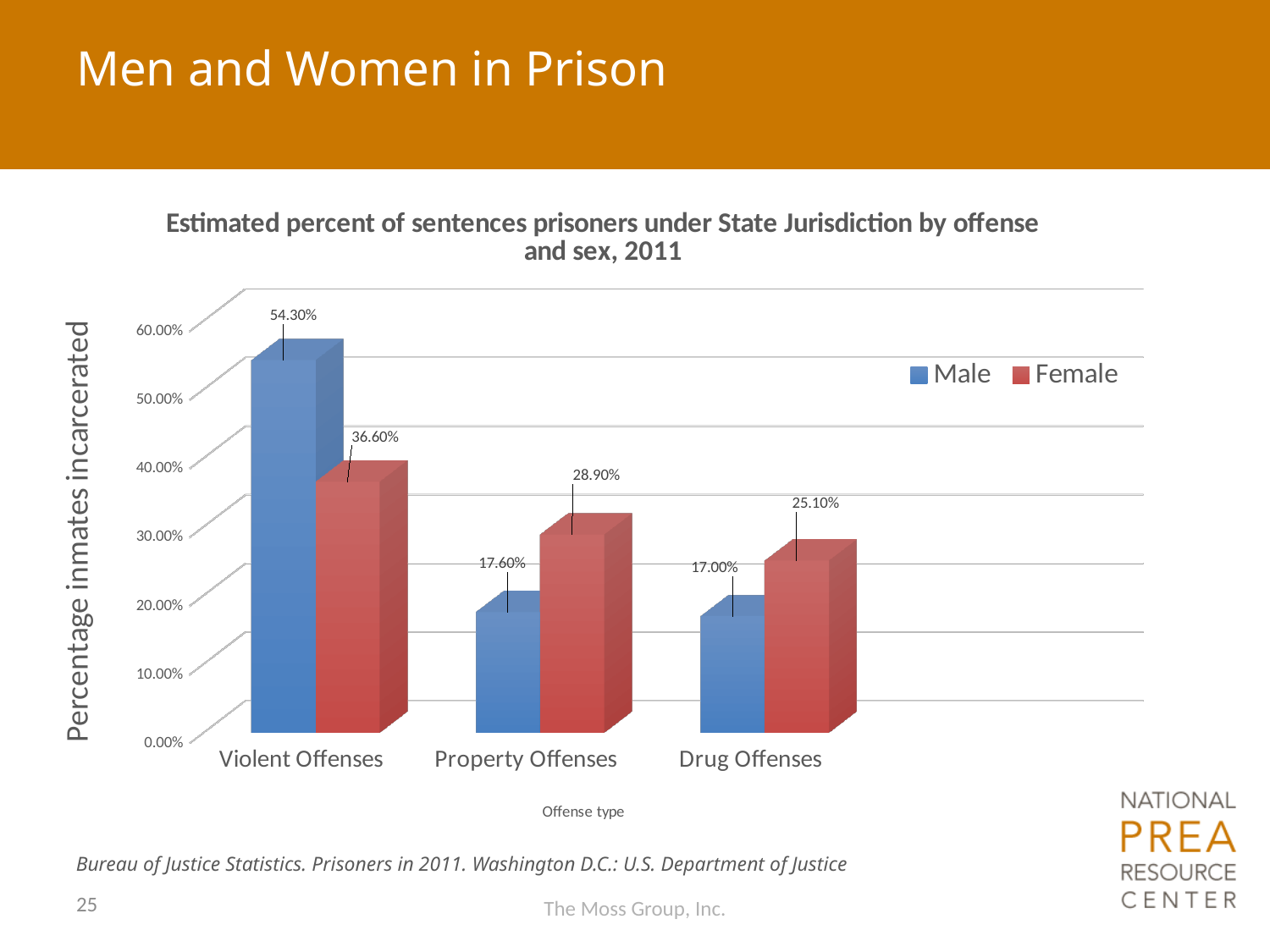
What is the Male value for Drug Offenses? 17.00% What is the Female value for Property Offenses? 28.90% What is the difference between the Male and Female values for Violent Offenses? 17.70% What kind of chart is shown on the slide? Bar chart Which offense type has the lowest Female value? Drug Offenses Which offense type has the highest Male value? Violent Offenses What is the label of the y axis? Percentage inmates incarcerated What is the Male value for Violent Offenses? 54.30% Which is larger for Property Offenses, the Male value or the Female value? Female How many offense types are shown on the x axis? 3 What is the Female value for Violent Offenses? 36.60% How many series does the legend list? 2